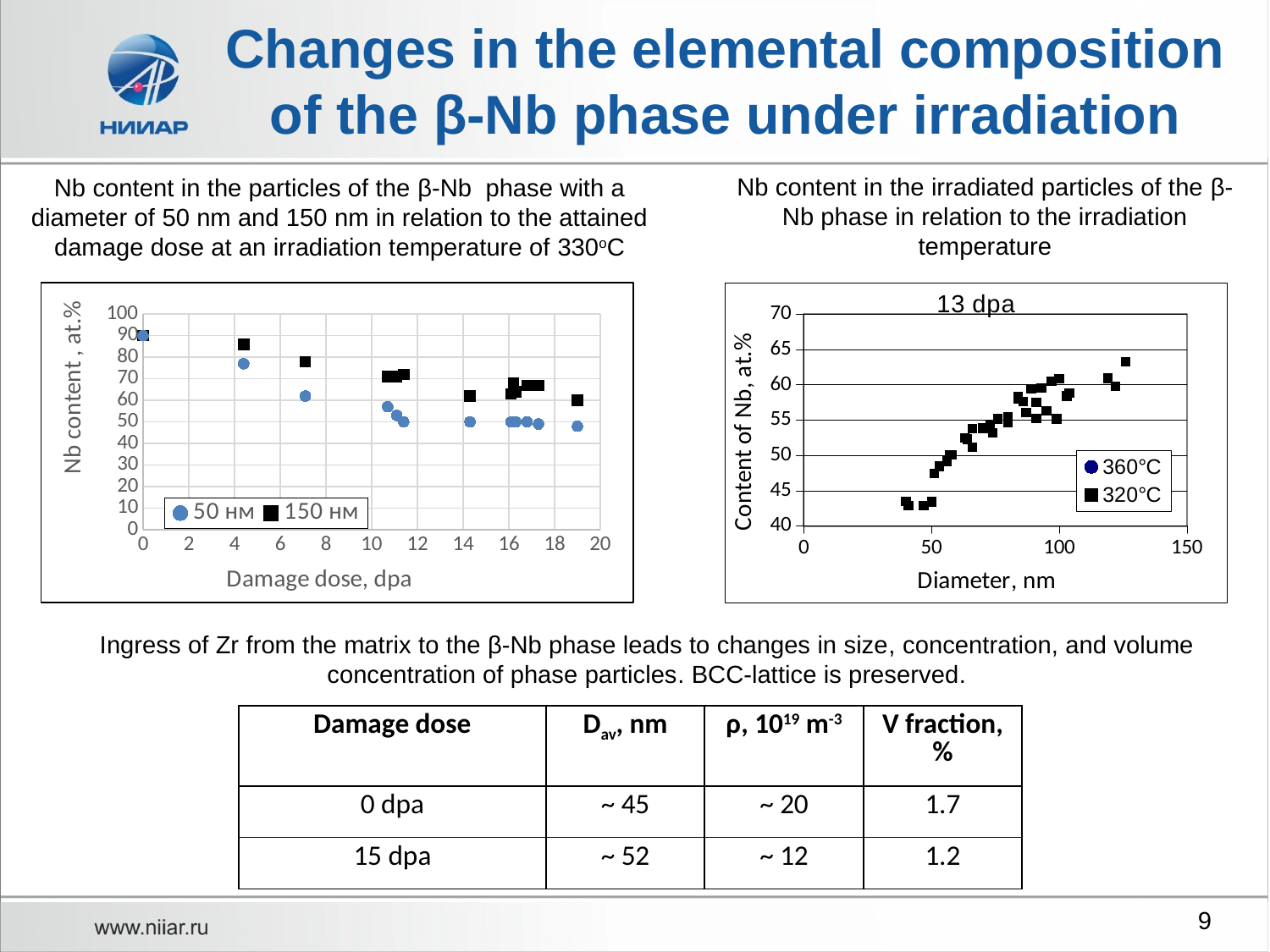
In the left chart, is the 150 нм value at about 4.5 dpa greater or less than 80? greater What is the title shown on the right chart? 13 dpa What kind of chart is the left chart (Nb content vs damage dose)? scatter chart How many series does the legend of the right chart (13 dpa) list? 2 How many series does the legend of the left chart list? 2 In the right chart (13 dpa), do the Nb content values rise or fall as the diameter increases? rise In the right chart (13 dpa), is the value at a diameter of about 40 nm greater or less than 45? less In the left chart, is the 150 нм value at about 19 dpa greater or less than 70? less What is the x-axis title of the right chart (13 dpa)? Diameter, nm In the left chart, do the Nb content values rise or fall as the damage dose increases? fall In the left chart, at about 4.5 dpa, which series has the higher Nb content, 50 нм or 150 нм? 150 нм